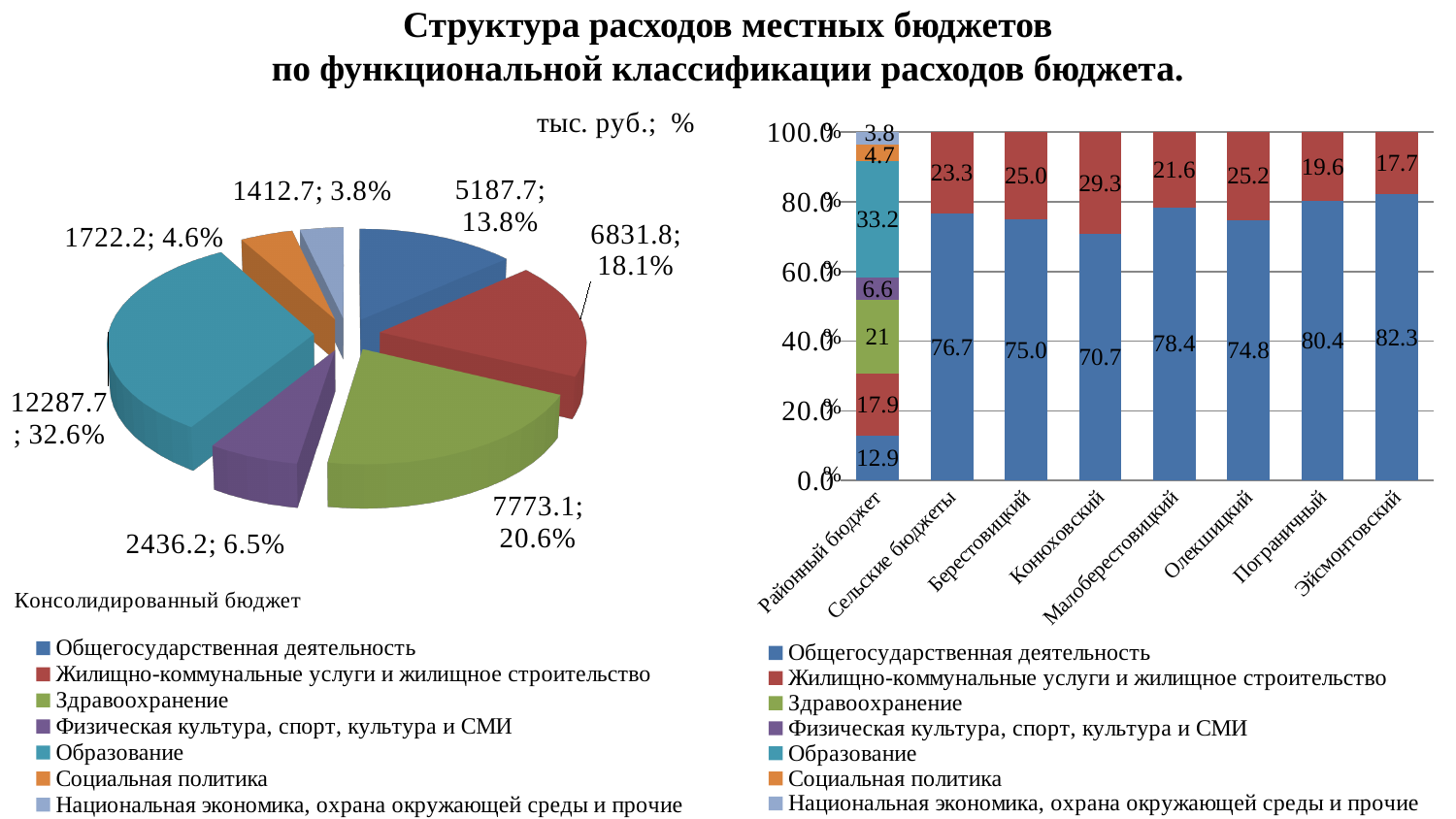
In the right chart, what is the value of Жилищно-коммунальные услуги и жилищное строительство for Конюховский? 29.3 In the left pie chart, how many slices are there? 7 In the right chart, what is the value of Образование for Районный бюджет? 33.2 In the right chart, what is the value of Общегосударственная деятельность for Эйсмонтовский? 82.3 What kind of chart is the right chart? stacked bar chart In the left pie chart, what is the value in тыс. руб. for Здравоохранение? 7773.1 What kind of chart is the left chart (Консолидированный бюджет)? pie chart In the left pie chart, which category has the smallest share? Национальная экономика, охрана окружающей среды и прочие In the right chart, what is the difference between the Общегосударственная деятельность values for Пограничный and Берестовицкий? 5.4 In the right chart, which category has the highest value for Общегосударственная деятельность? Эйсмонтовский In the right chart, how many series does the legend list? 7 In the left pie chart, what share does Образование have? 32.6%